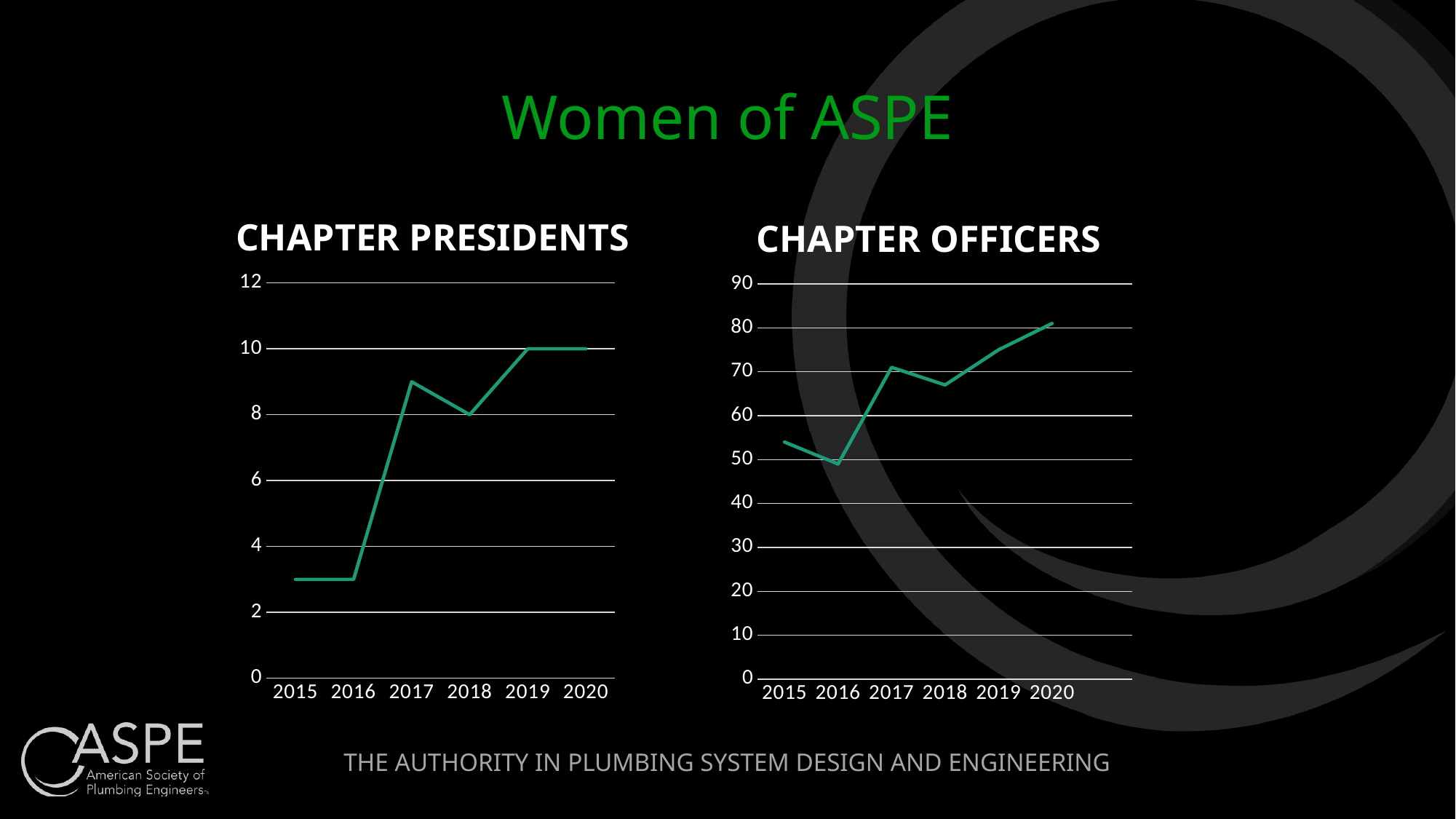
On the Chapter Presidents chart, is the value for 2017 greater or less than 8? greater On the Chapter Presidents chart, is the value for 2015 greater or less than 4? less On the Chapter Presidents chart, what is the value for 2018? 8 On the Chapter Officers chart, which year has the larger value, 2017 or 2018? 2017 On the Chapter Presidents chart, what is the value for 2019? 10 What kind of chart is the Chapter Presidents chart? line chart How many years are plotted on the Chapter Presidents chart? 6 On the Chapter Officers chart, is the value for 2016 greater or less than 60? less On the Chapter Officers chart, which year has the lowest value? 2016 What is the title of the slide containing the two charts? Women of ASPE On the Chapter Officers chart, which year has the highest value? 2020 On the Chapter Presidents chart, do the values overall rise or fall from 2015 to 2020? rise